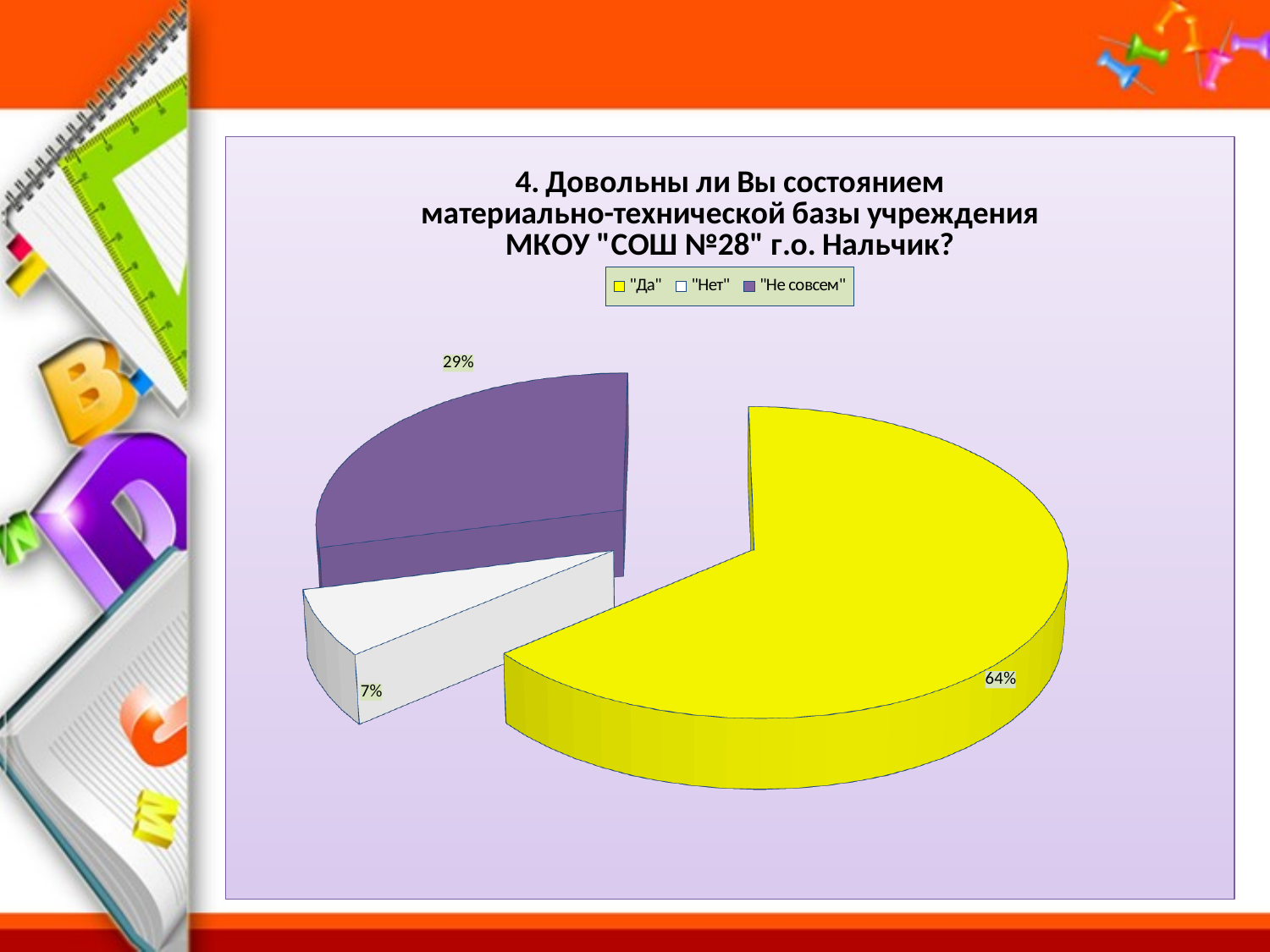
Which is larger, the "Нет" slice or the "Не совсем" slice? "Не совсем" How many entries does the legend list? 3 What share of the pie does "Не совсем" have? 29% Which category has the smallest slice of the pie? "Нет" What colour is the "Да" slice? yellow What is the difference in percentage points between the "Не совсем" and "Нет" slices? 22 What share of the pie does "Да" have? 64% What share of the pie does "Нет" have? 7% Which category has the largest slice of the pie? "Да" What kind of chart is shown on the slide? pie chart What is the difference in percentage points between the "Да" and "Не совсем" slices? 35 How many categories does the pie chart have? 3